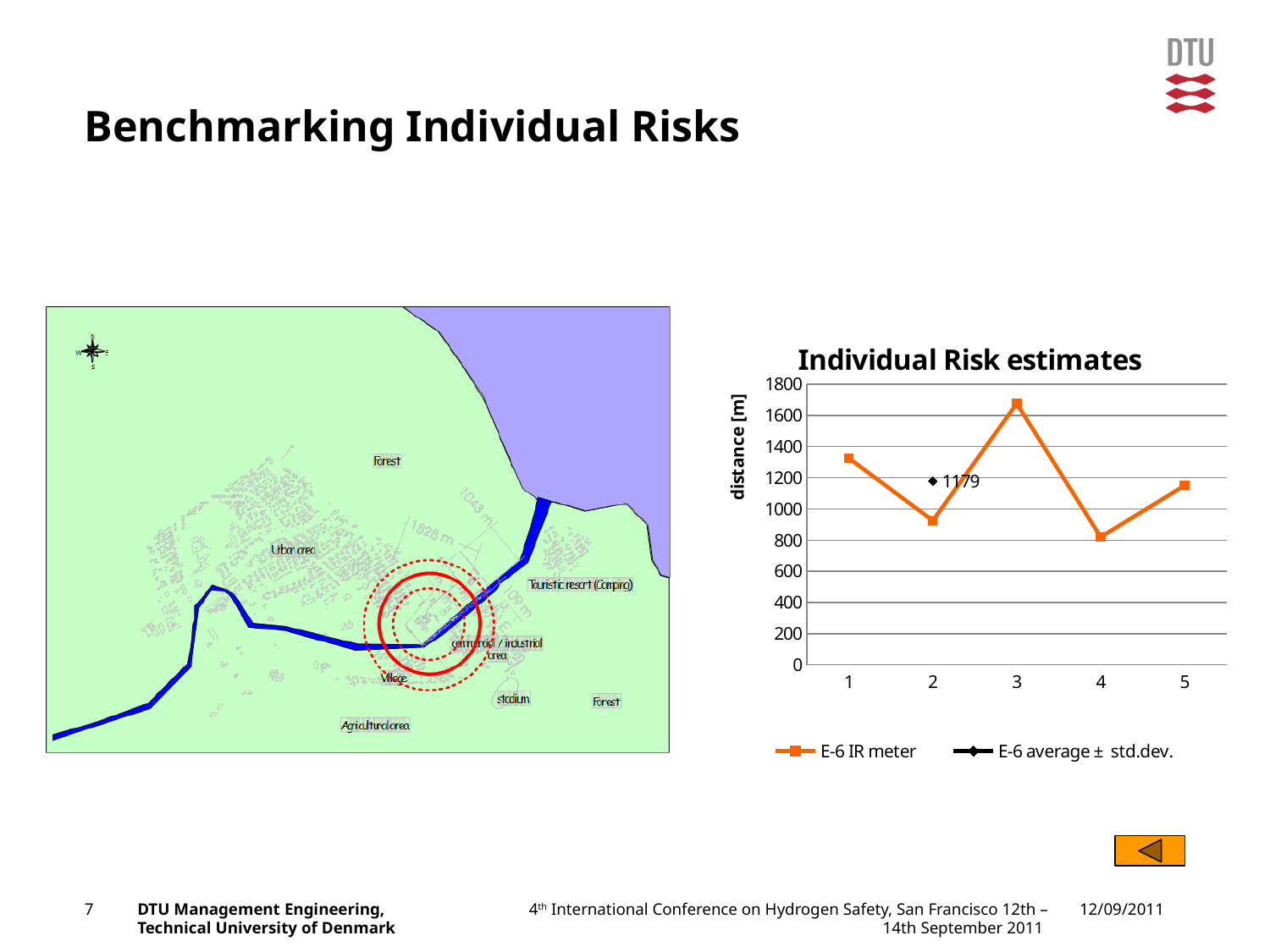
Is the E-6 IR meter value at category 4 greater or less than 1000? less How many points are plotted for the E-6 IR meter series in the "Individual Risk estimates" chart? 5 What colour is the E-6 IR meter line in the "Individual Risk estimates" chart? orange At which x-axis category does the E-6 IR meter series reach its lowest value? 4 How many series does the legend of the "Individual Risk estimates" chart list? 2 What kind of chart is "Individual Risk estimates"? line chart At which x-axis category does the E-6 IR meter series reach its highest value? 3 Is the E-6 IR meter value at category 3 greater or less than 1600? greater What value is labelled for the E-6 average ± std.dev. point in the "Individual Risk estimates" chart? 1179 What is the y-axis title of the "Individual Risk estimates" chart? distance [m] Does the E-6 IR meter series rise or fall from category 1 to category 2? fall Which has the larger E-6 IR meter value, category 1 or category 2? 1